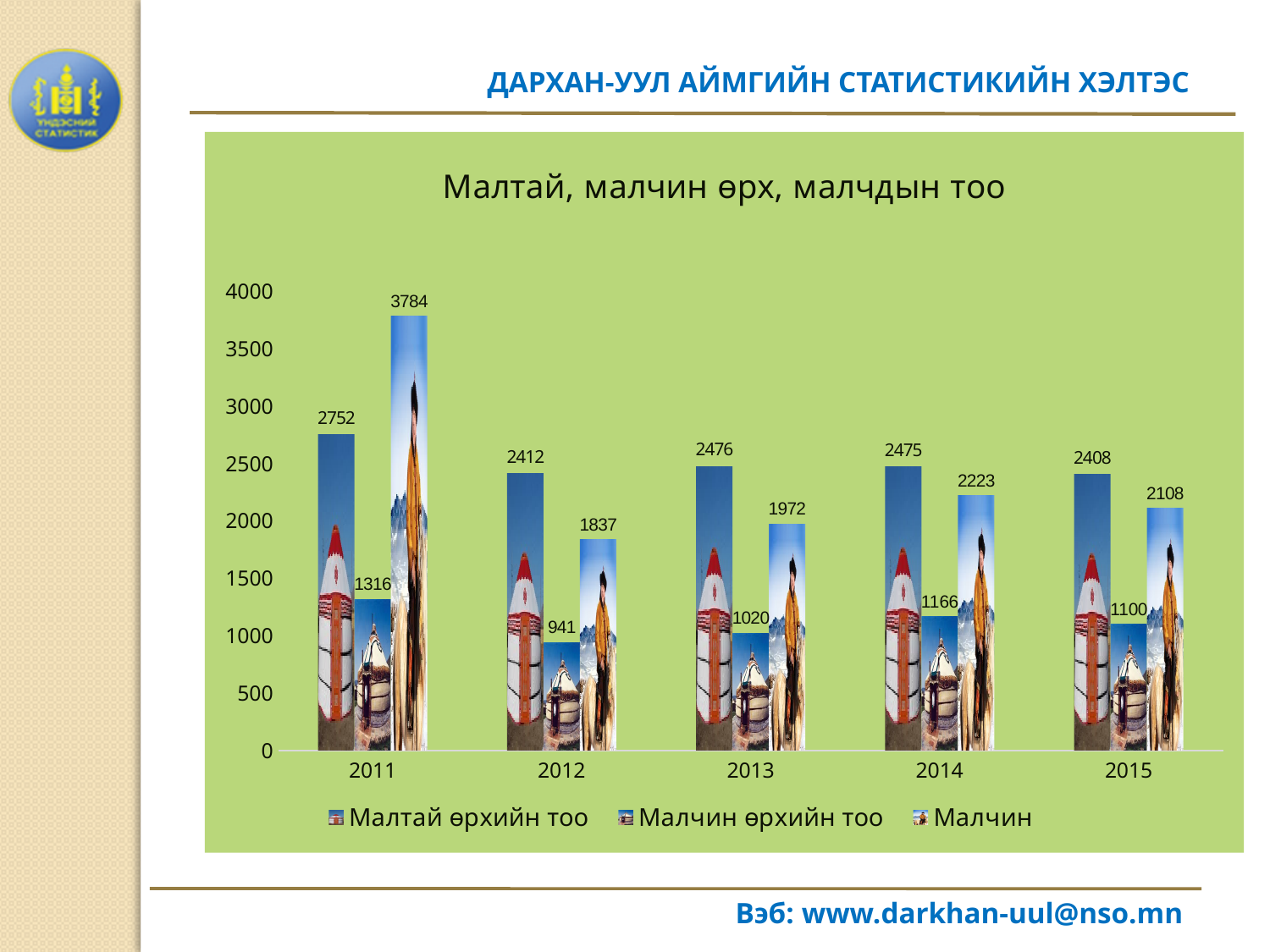
What is the title of the chart? Малтай, малчин өрх, малчдын тоо What is the difference between Малчин in 2011 and Малчин in 2012? 1947 Does the Малчин өрхийн тоо series rise or fall from 2012 to 2014? Rise How many years are shown on the x axis? 5 In which year is the Малчин өрхийн тоо series lowest? 2012 What is the value of Малчин in 2014? 2223 Which is larger: Малчин in 2013 or Малчин in 2015? Малчин in 2015 In which year is the Малчин series highest? 2011 What is the value of Малчин өрхийн тоо in 2012? 941 What kind of chart is shown on the slide? Bar chart How many series does the legend list? 3 What is the value of Малтай өрхийн тоо in 2011? 2752